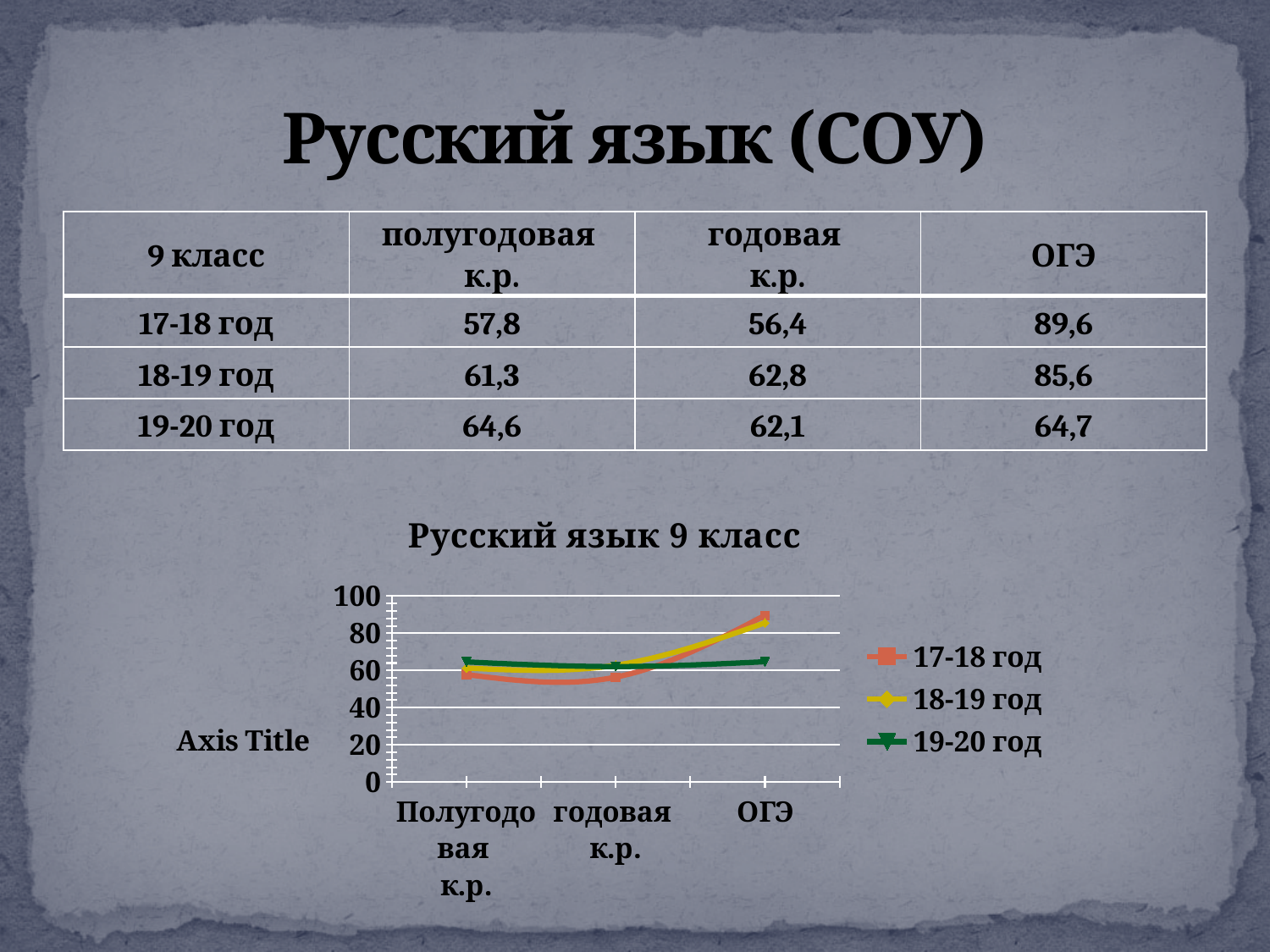
What is the difference between the ОГЭ values for 17-18 год and 19-20 год? 24,9 Which series has the lowest value at Полугодовая к.р.? 17-18 год How many series does the chart legend list? 3 What is the value for 17-18 год at ОГЭ? 89,6 Does the 17-18 год line rise or fall from годовая к.р. to ОГЭ? rise At ОГЭ, which series has the larger value: 17-18 год or 19-20 год? 17-18 год How many categories are shown along the x axis of the chart? 3 What label is shown on the vertical axis of the chart? Axis Title Is the value for 17-18 год at ОГЭ greater or less than 80? greater What is the title of the chart? Русский язык 9 класс What kind of chart is shown on the slide? line chart Is the value for 19-20 год at ОГЭ greater or less than 80? less